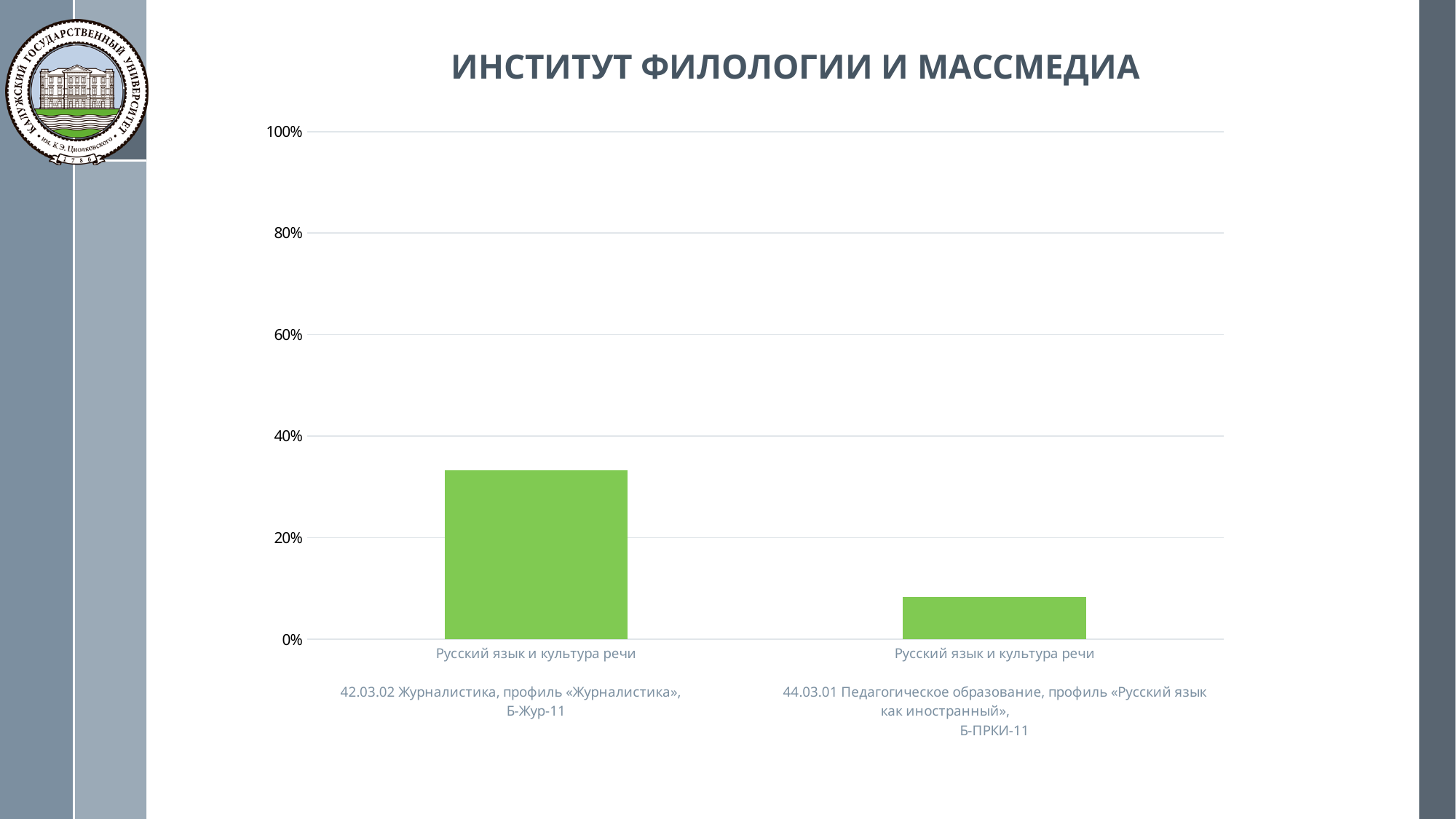
What is the highest value shown on the vertical axis of the chart? 100% Is the value for Б-Жур-11 greater or less than 20%? greater Do the bar values rise or fall from left to right along the x axis? fall How many bars are plotted in the chart? 2 Which group has the highest value in the chart? Б-Жур-11 What kind of chart is shown on the slide? bar chart Which group has the lowest value in the chart? Б-ПРКИ-11 What discipline is named under both bars of the chart? Русский язык и культура речи What is the title of the slide containing the chart? ИНСТИТУТ ФИЛОЛОГИИ И МАССМЕДИА Which group has the higher bar, Б-Жур-11 or Б-ПРКИ-11? Б-Жур-11 Is the value for Б-ПРКИ-11 greater or less than 20%? less Is the value for Б-Жур-11 greater or less than 40%? less